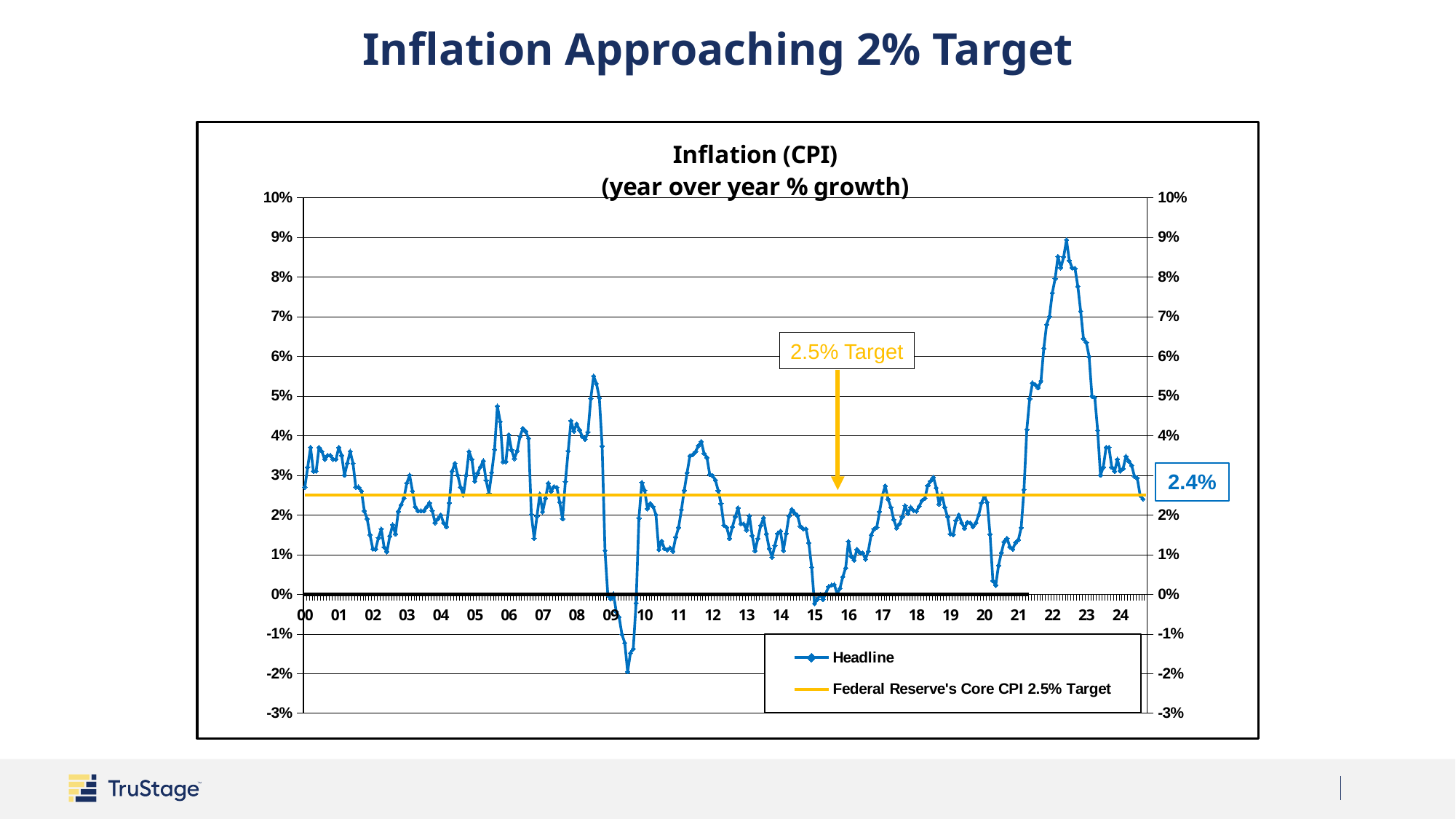
Is the lowest Headline inflation value in 09 greater or less than -1%? less What kind of chart is shown on the slide? Line chart Which is larger, the latest Headline value of 2.4% or the Federal Reserve's 2.5% target? The 2.5% target In which year does the Headline inflation line reach its lowest point? 09 What value does the Federal Reserve's Core CPI target line sit at? 2.5% What is the title printed inside the chart area? Inflation (CPI) (year over year % growth) In which year does the Headline inflation line reach its highest point? 22 How many year labels are shown on the x axis? 25 What is the most recent Headline inflation value labeled on the chart? 2.4% Does Headline inflation rise or fall from 22 to 24? Fall How many series does the legend list? 2 Is the peak Headline inflation value in 22 greater or less than 8%? greater